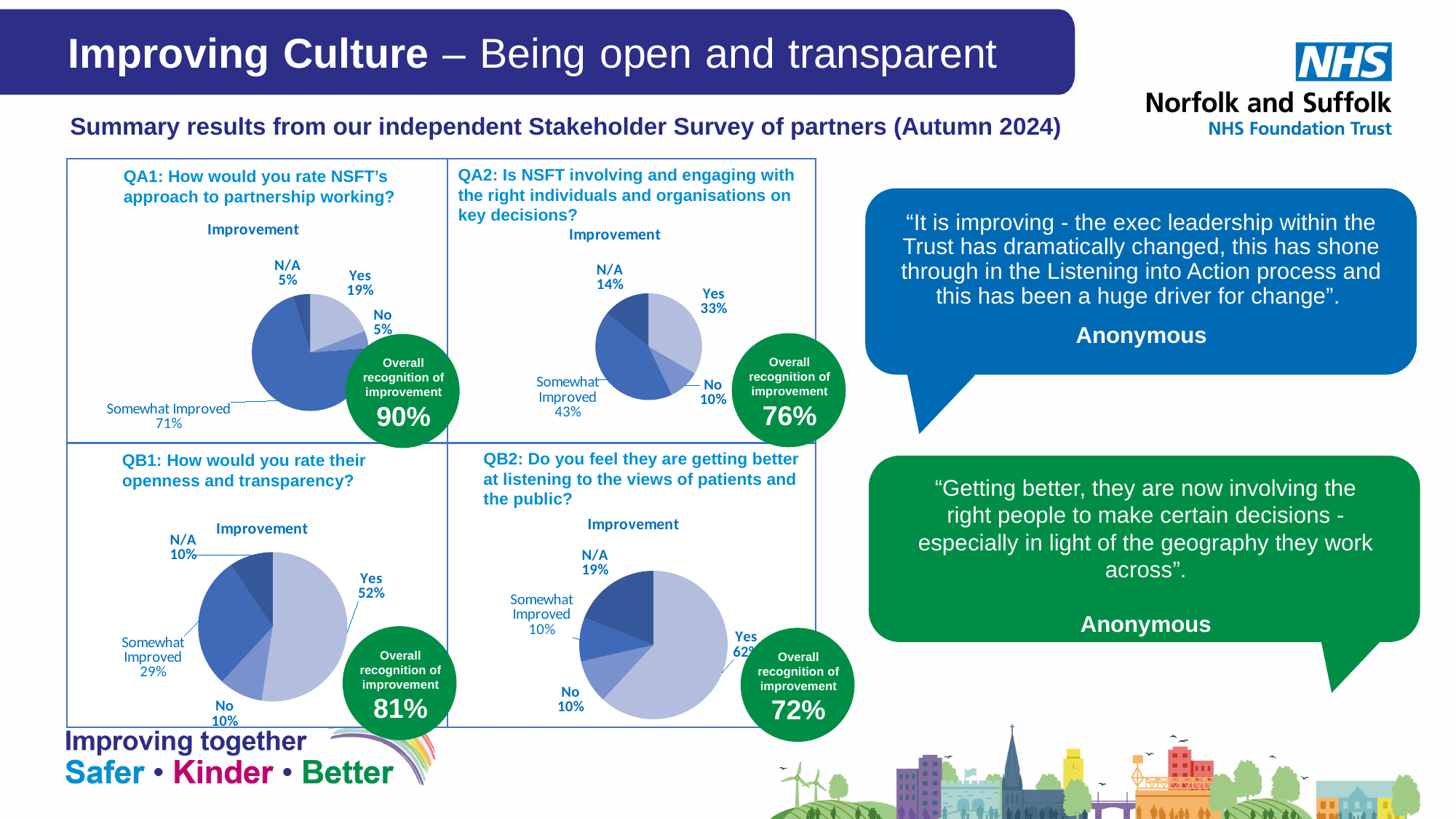
In the QA2 chart (involving and engaging the right individuals), what percentage answered Yes? 33% In the QA1 chart (approach to partnership working), what percentage answered Somewhat Improved? 71% In the QA1 chart, which response category has the largest share? Somewhat Improved In the QB1 chart (openness and transparency), what percentage answered N/A? 10% How many slices does the QB2 pie chart have? 4 In the QB2 chart (listening to the views of patients and the public), what percentage answered Yes? 62% In the QB1 chart, what is the difference in percentage points between Yes and Somewhat Improved? 23 In the QB2 chart, which response category has the largest share? Yes What type of chart is used for QA1? Pie chart What overall recognition of improvement figure is shown next to the QB1 chart? 81% In the QA2 chart, which is larger: the Yes share or the Somewhat Improved share? Somewhat Improved In the QA2 chart, which response category has the smallest share? No